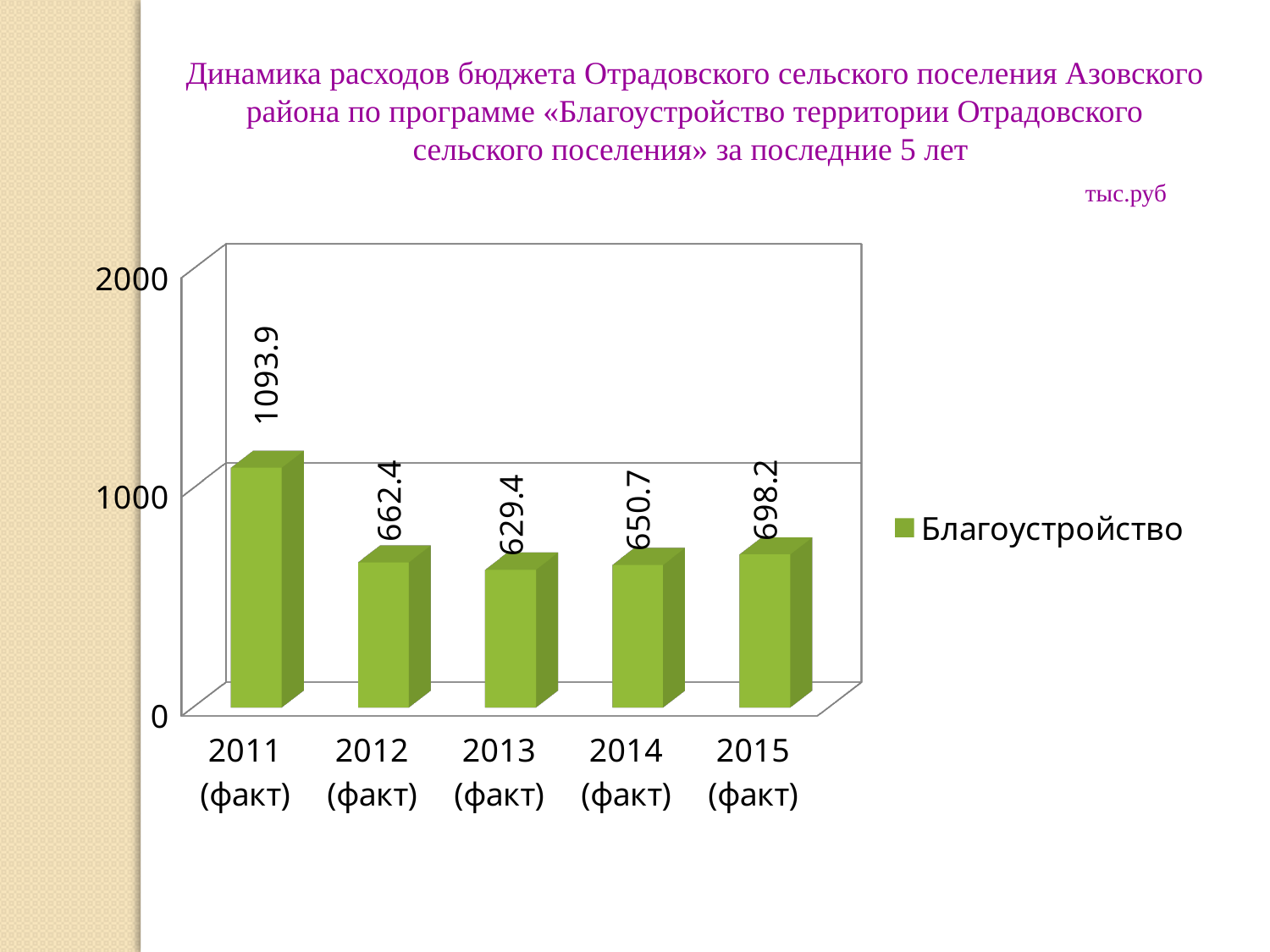
What kind of chart is shown on the slide? bar chart What is the value for 2015 (факт)? 698.2 How many years are shown on the x axis? 5 Is the value for 2011 (факт) greater or less than 1000? greater What is the value for 2013 (факт)? 629.4 Which year has the highest value? 2011 (факт) What series name does the legend show? Благоустройство What is the difference between the values for 2011 (факт) and 2012 (факт)? 431.5 Which year has the lowest value? 2013 (факт) Which is larger, the value for 2012 (факт) or the value for 2014 (факт)? 2012 (факт) What is the difference between the values for 2015 (факт) and 2014 (факт)? 47.5 What is the value for 2011 (факт)? 1093.9